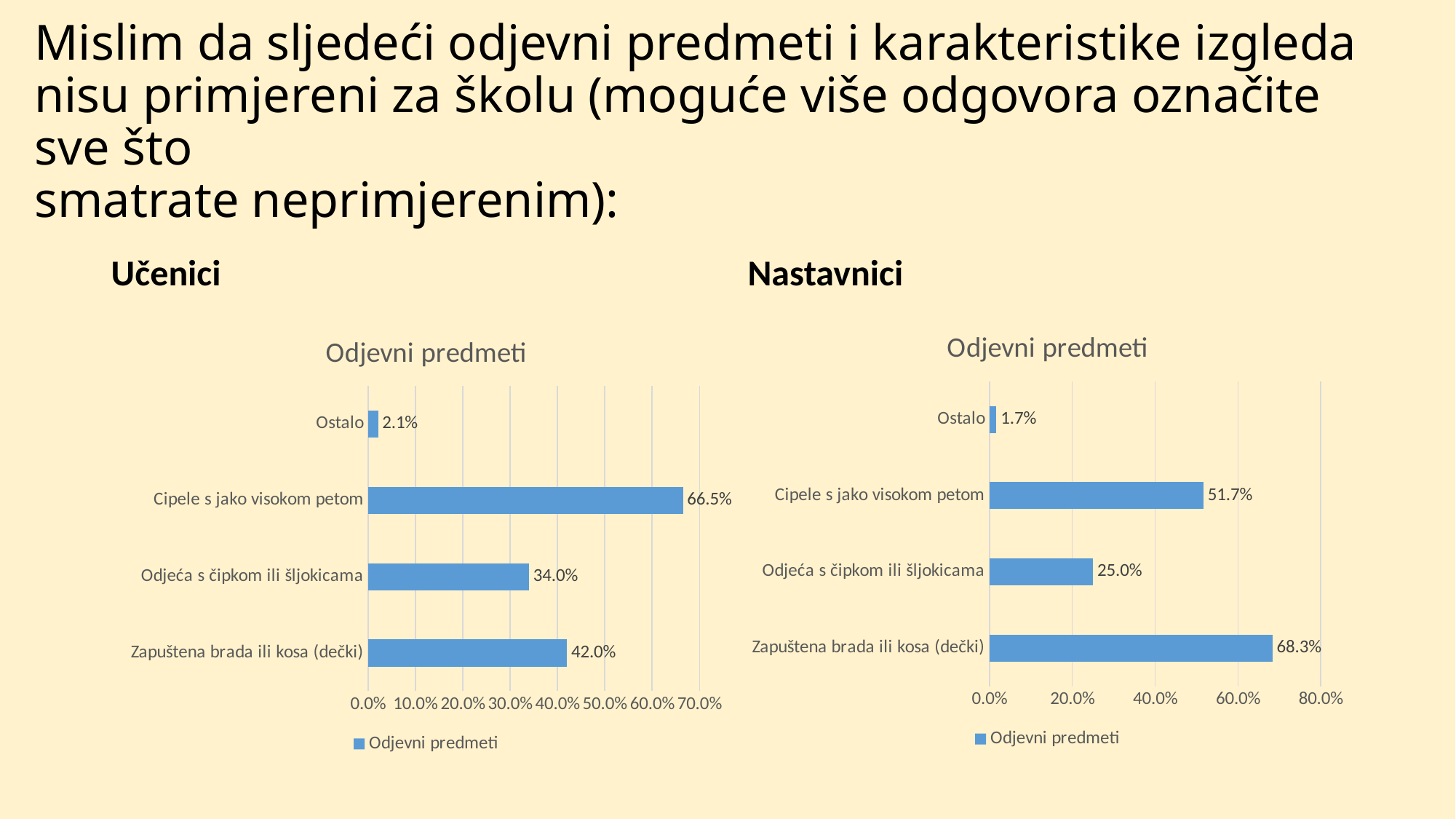
In the Nastavnici chart, which category has the lowest value? Ostalo Which is larger in the Učenici chart: Zapuštena brada ili kosa (dečki) or Odjeća s čipkom ili šljokicama? Zapuštena brada ili kosa (dečki) In the Nastavnici chart, is the value for Cipele s jako visokom petom greater or less than 40.0%? greater How many categories are shown in the Učenici chart? 4 In the Nastavnici chart, what is the value for Zapuštena brada ili kosa (dečki)? 68.3% In the Nastavnici chart, what is the value for Odjeća s čipkom ili šljokicama? 25.0% In the Nastavnici chart, what is the difference between Zapuštena brada ili kosa (dečki) and Cipele s jako visokom petom? 16.6% What is the title of the Učenici chart? Odjevni predmeti In the Učenici chart, which category has the highest value? Cipele s jako visokom petom What kind of chart is the Nastavnici chart? bar chart In the Učenici chart, what is the difference between Zapuštena brada ili kosa (dečki) and Odjeća s čipkom ili šljokicama? 8.0% In the Učenici chart, what is the value for Cipele s jako visokom petom? 66.5%